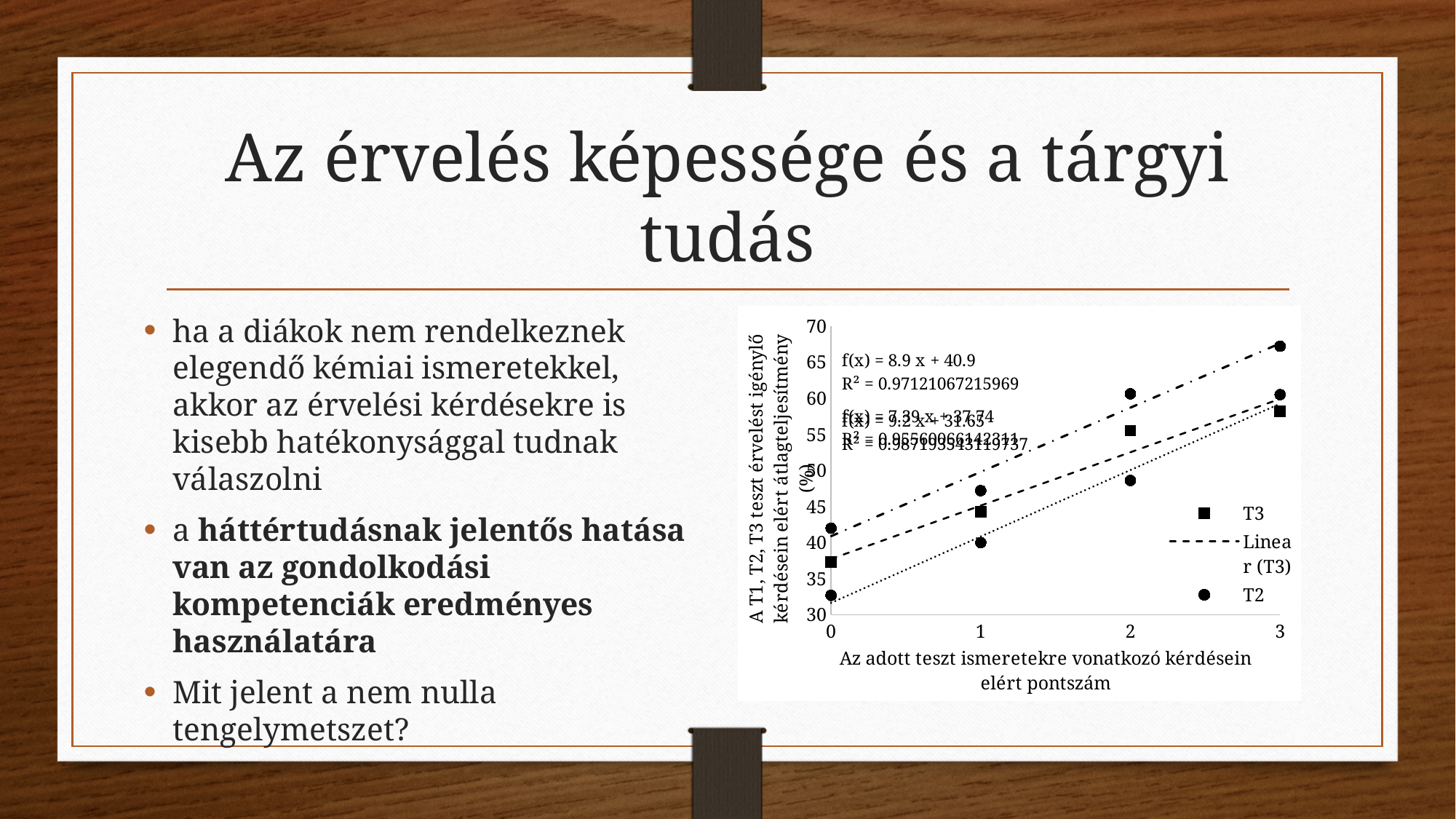
At which x-axis value is the T3 series lowest? 0 What is the title of the x axis? Az adott teszt ismeretekre vonatkozó kérdésein elért pontszám Is the T3 value at x = 1 greater or less than 40? greater How many data points does the T3 series have? 4 Is the T3 value at x = 0 greater or less than 40? less Which is larger for the T3 series: the value at x = 3 or the value at x = 0? x = 3 What kind of chart is shown on the slide? scatter chart What marker shape does the legend use for T3? square Do the T3 values rise or fall as the x-axis value increases from 0 to 3? rise At which x-axis value is the T3 series highest? 3 What is the first trendline equation printed on the chart? f(x) = 8.9 x + 40.9 Is the T3 value at x = 3 greater or less than 55? greater